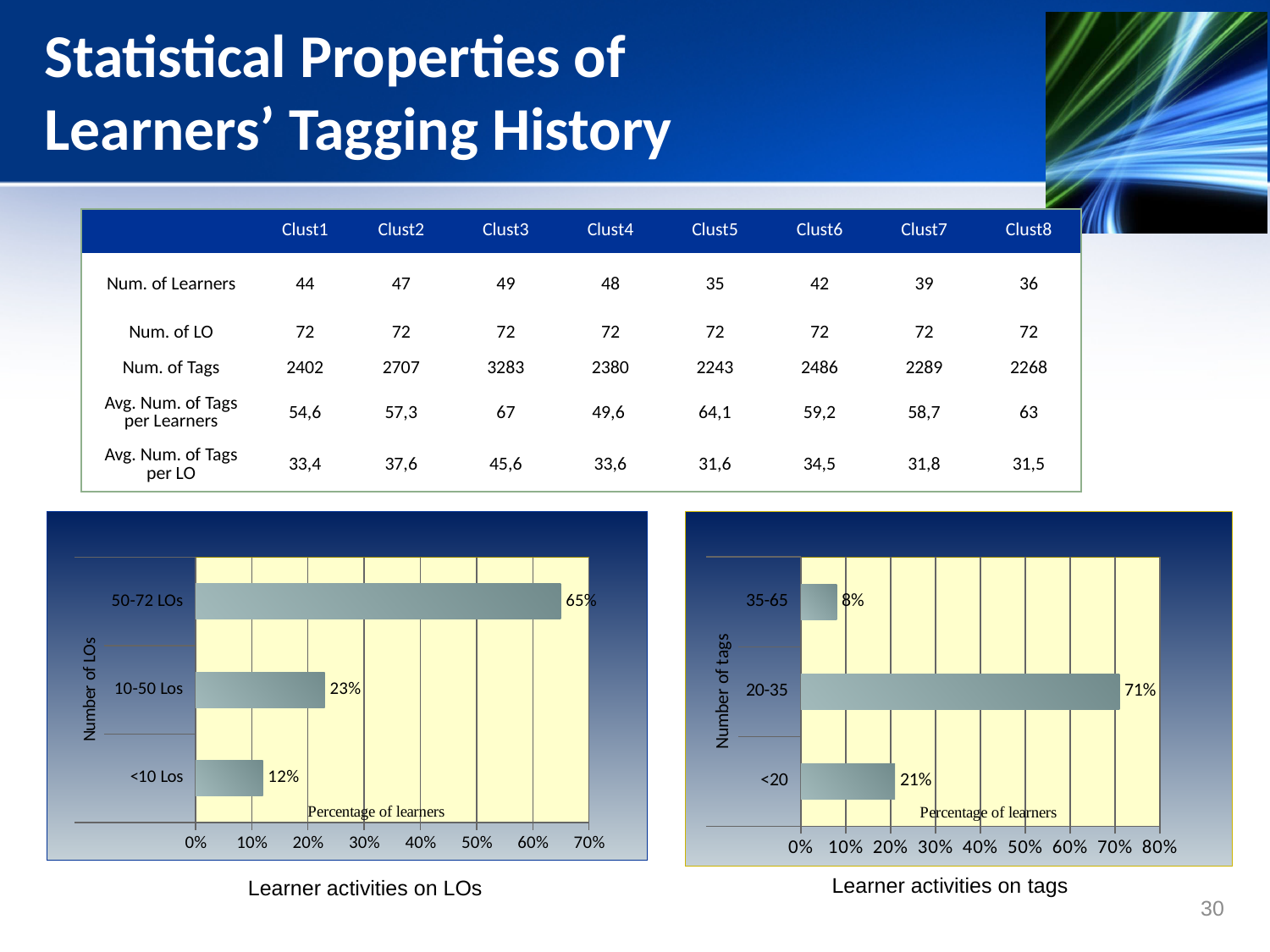
In the 'Learner activities on tags' chart, what is the difference between the percentages for 20-35 and <20? 50% What type of chart is the 'Learner activities on tags' chart? Bar chart In the 'Learner activities on tags' chart, which category has the larger percentage: <20 or 35-65? <20 In the 'Learner activities on tags' chart, what percentage of learners is shown for the 35-65 tags category? 8% What is the label of the vertical axis in the 'Learner activities on tags' chart? Number of tags In the 'Learner activities on LOs' chart, what percentage of learners is shown for the 50-72 LOs category? 65% How many categories are shown in the 'Learner activities on LOs' chart? 3 In the 'Learner activities on LOs' chart, what is the difference between the percentages for 50-72 LOs and 10-50 Los? 42% In the 'Learner activities on tags' chart, what percentage of learners is shown for the 20-35 tags category? 71% In the 'Learner activities on LOs' chart, what percentage of learners is shown for the <10 Los category? 12% In the 'Learner activities on tags' chart, which category has the lowest percentage of learners? 35-65 In the 'Learner activities on LOs' chart, which category has the highest percentage of learners? 50-72 LOs